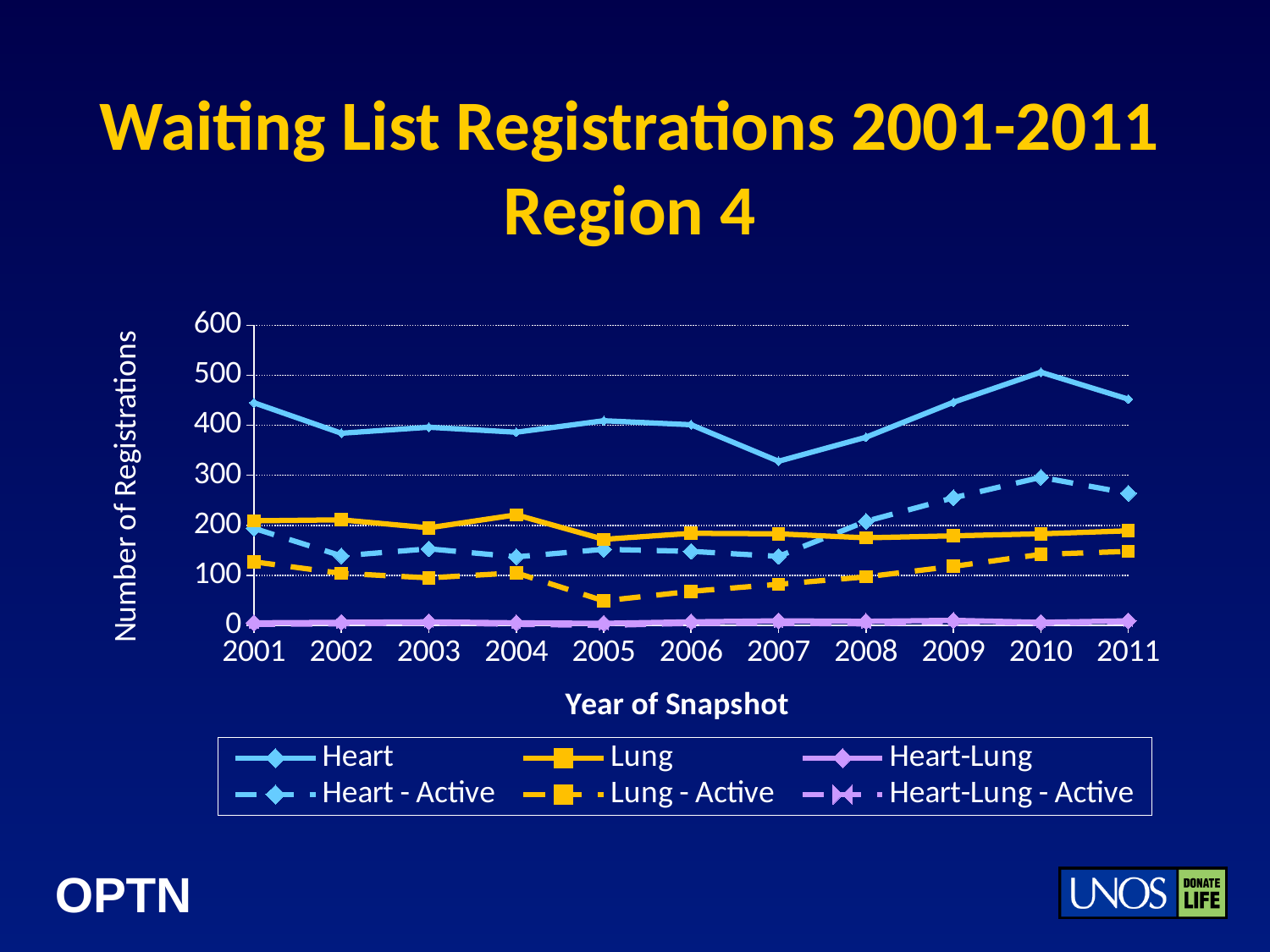
Is the value for Lung - Active in 2005 greater or less than 100? less In 2011, which is larger: Heart - Active or Lung? Heart - Active In which year is the Heart series at its lowest? 2007 Is the value for Heart in 2007 greater or less than 400? less In which year is the Lung - Active series at its lowest? 2005 In which year is the Heart - Active series at its highest? 2010 In which year is the Heart series at its highest? 2010 How many years are plotted along the x axis? 11 What kind of chart is shown on the slide? Line chart What is the title of the x axis? Year of Snapshot How many series does the legend list? 6 Does the Heart series rise or fall from 2007 to 2010? rise